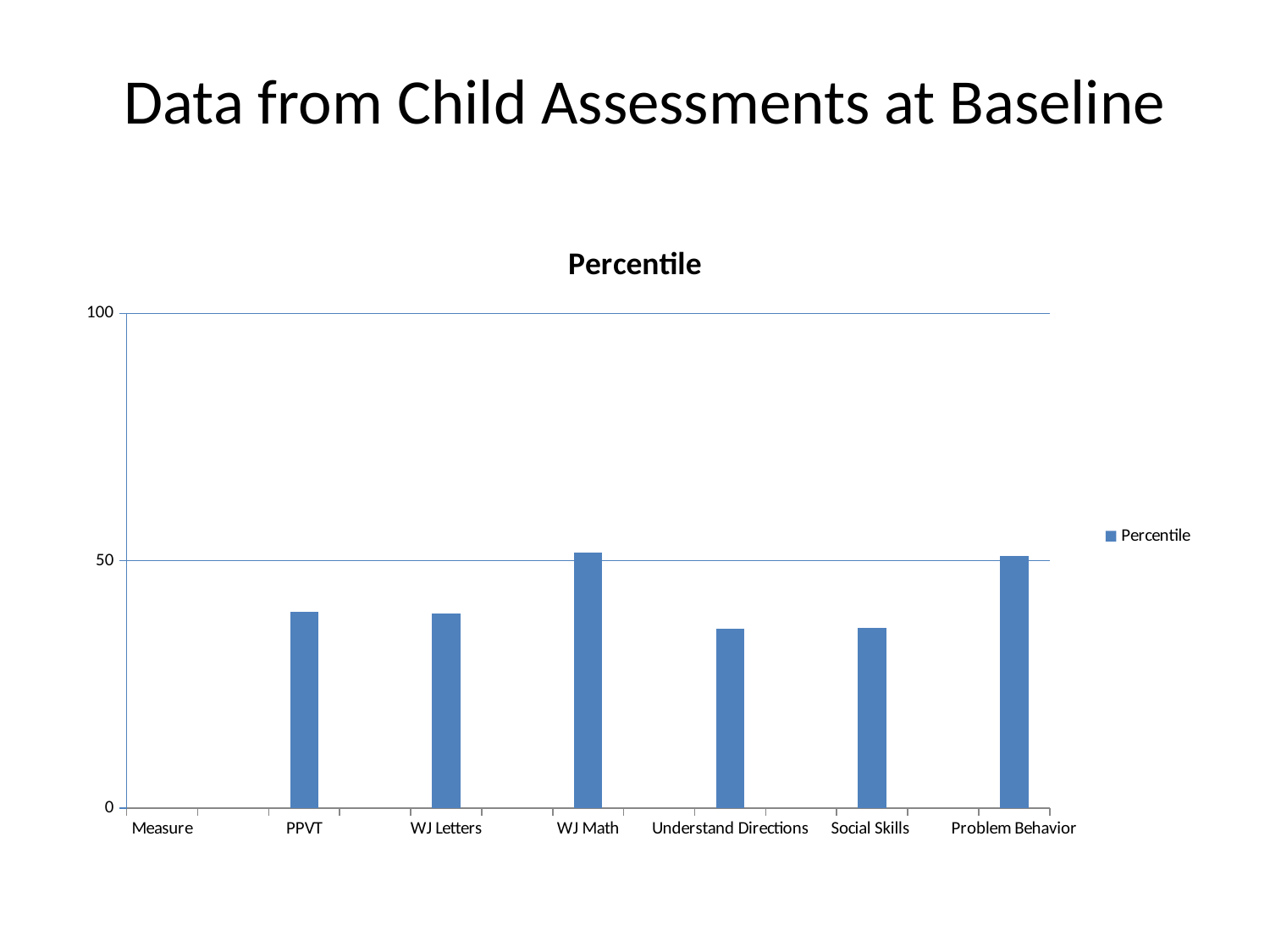
Is the value for Social Skills greater or less than 50? less How many bars are plotted in the chart? 6 Which is larger, the value for WJ Letters or the value for Social Skills? WJ Letters Is the value for WJ Math greater or less than 50? greater Which is larger, the value for Problem Behavior or the value for Understand Directions? Problem Behavior Is the value for Understand Directions greater or less than 50? less How many series does the legend list? 1 Which is larger, the value for WJ Math or the value for PPVT? WJ Math What is the title of the chart? Percentile What kind of chart is shown on the slide? Bar chart What is the name of the series shown in the legend? Percentile